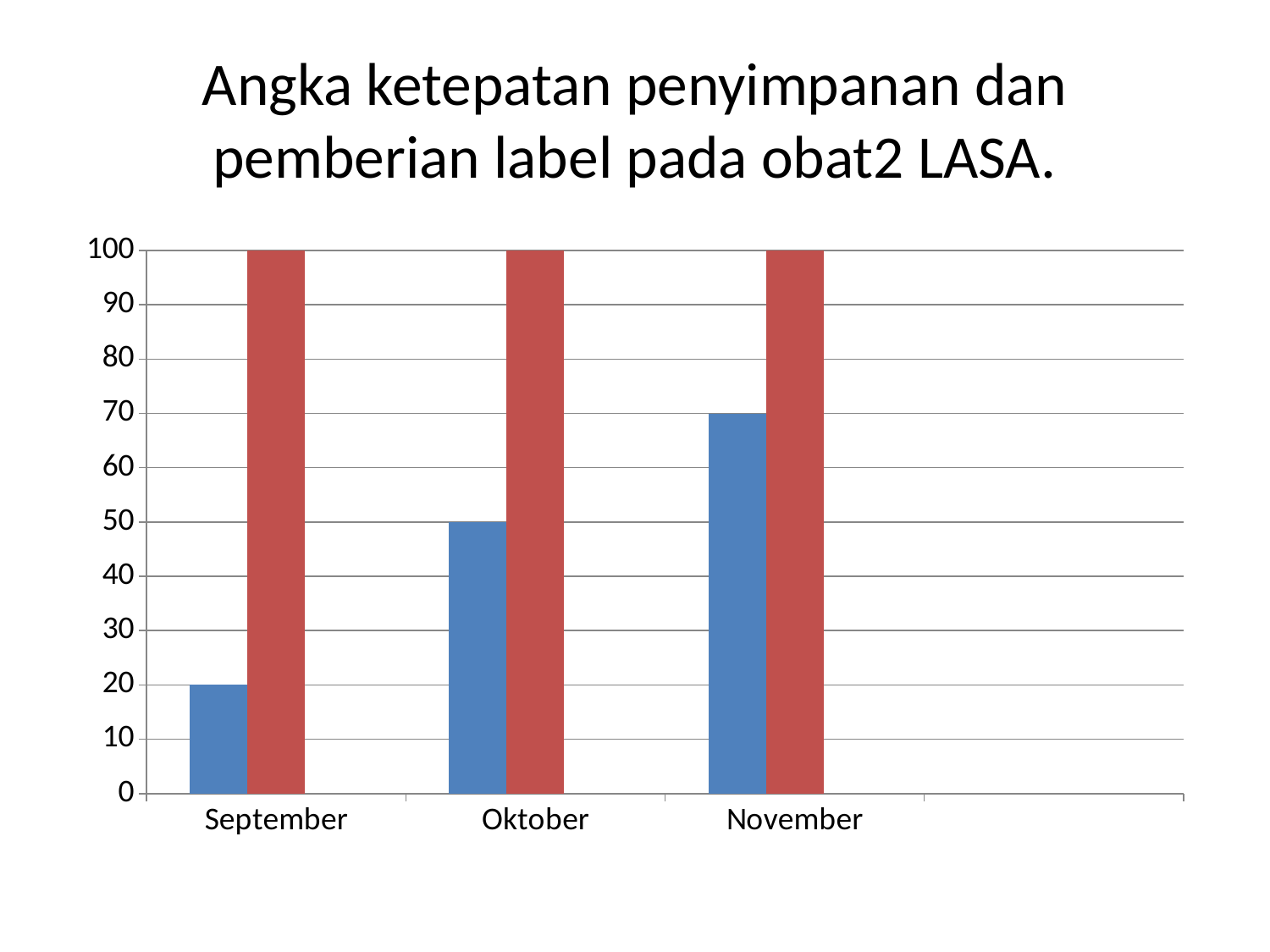
Do the blue bars rise or fall from September to November? rise What is the value of the red bar for September? 100 What is the value of the blue bar for Oktober? 50 What is the difference between the blue bar for November and the blue bar for September? 50 Which is larger, the blue bar for Oktober or the blue bar for November? November Which month has the lowest blue bar? September What is the value of the blue bar for November? 70 What kind of chart is shown on the slide? bar chart What is the value of the blue bar for September? 20 Is the value of the blue bar for Oktober greater or less than 40? greater How many months are labelled on the x axis? 3 Which month has the highest blue bar? November